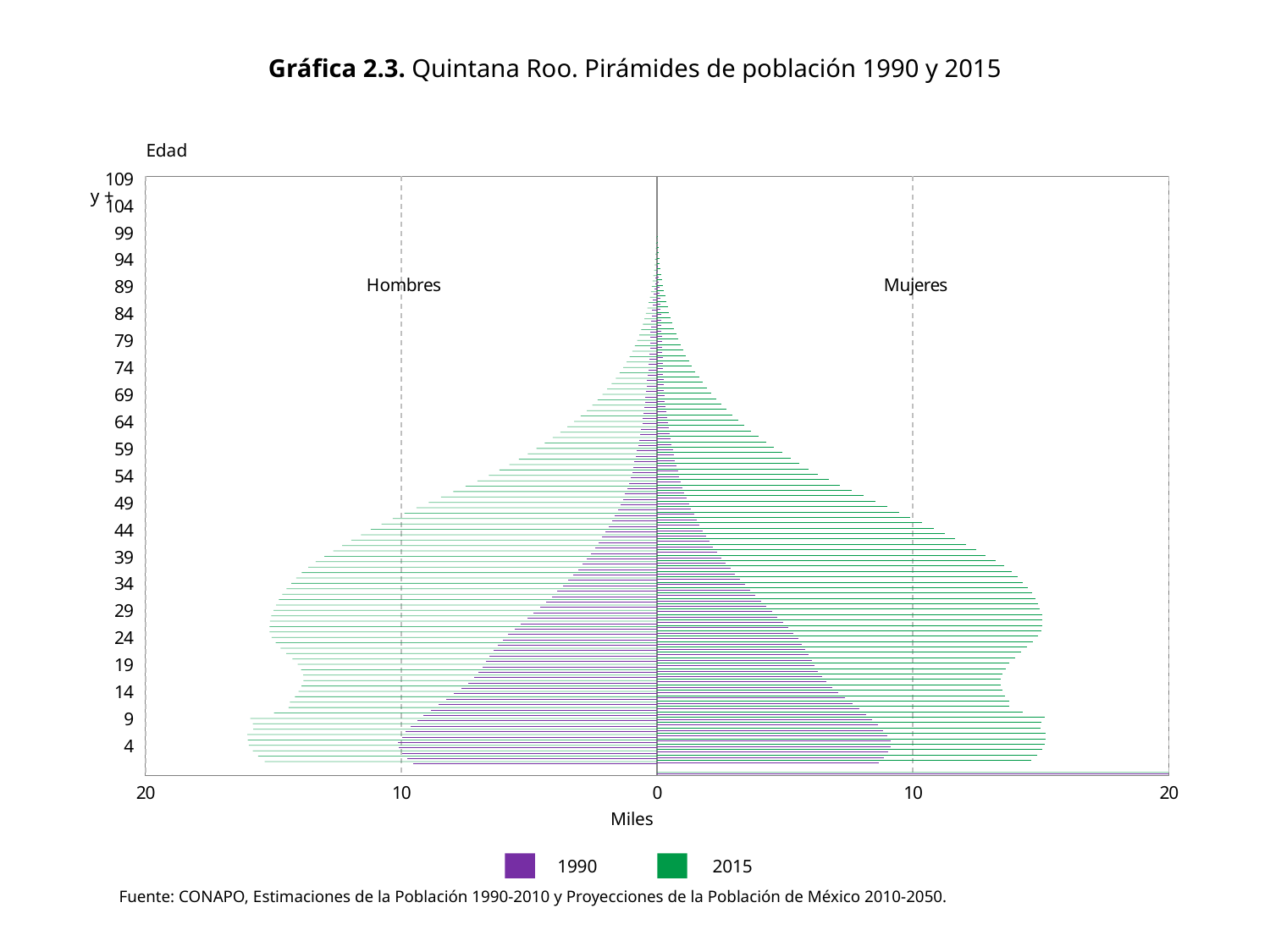
For men (Hombres) at age 29, which series has the larger value, 1990 or 2015? 2015 What kind of chart is shown on the slide? bar chart How many series does the legend list? 2 For women (Mujeres) at age 39, which series has the larger value, 1990 or 2015? 2015 Is the 1990 value for men (Hombres) at age 59 greater or less than 10? less Is the 1990 value for women (Mujeres) at age 29 greater or less than 10? less Is the 2015 value for men (Hombres) at age 64 greater or less than 10? less What is the label of the horizontal axis? Miles Which two years are compared in the legend? 1990 and 2015 Do the 2015 values for men (Hombres) increase or decrease as age rises from 34 to 89? decrease